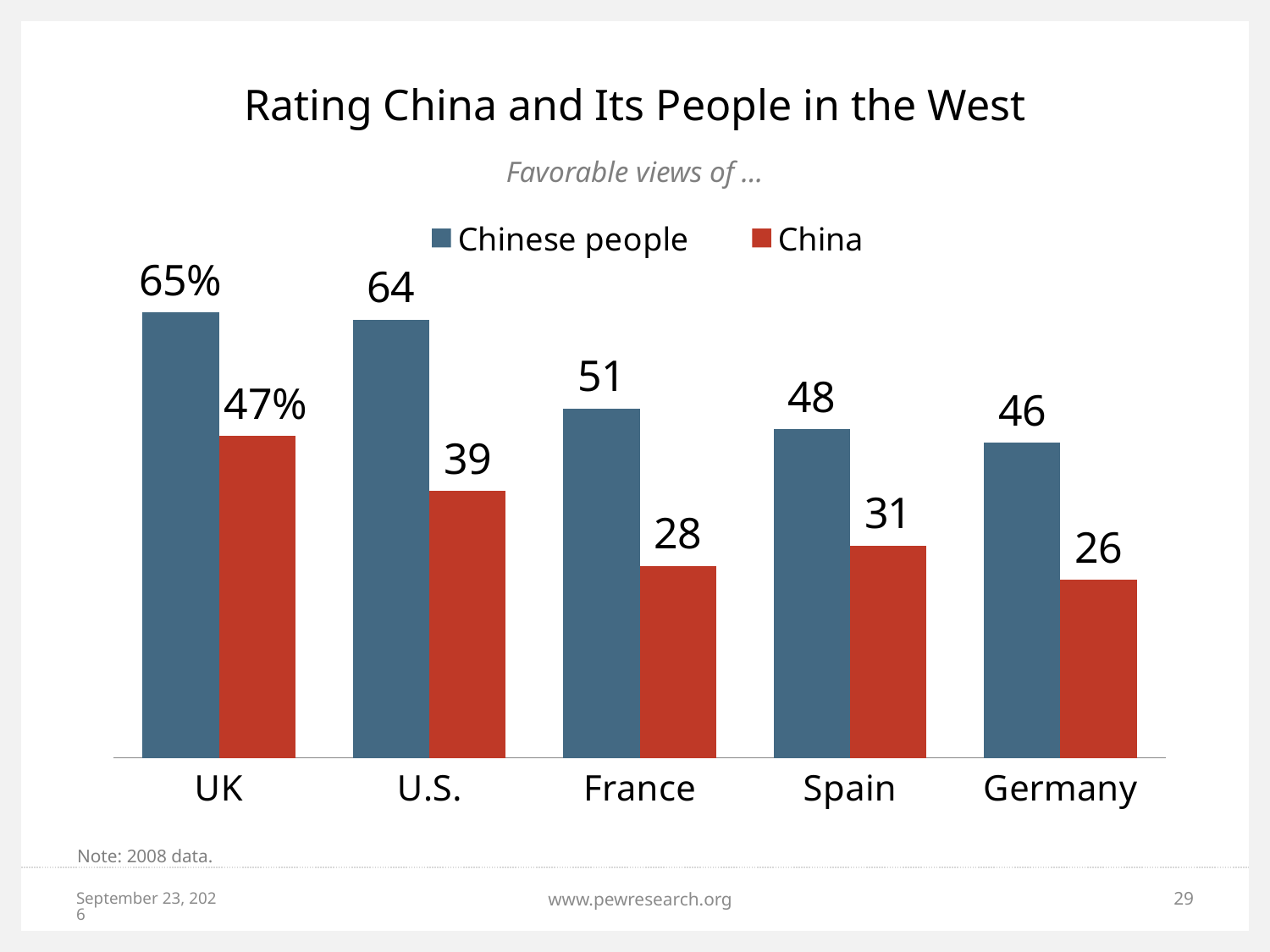
How many series does the legend list? 2 What is the value for China in Germany? 26 Which country has the highest value for Chinese people? UK Which is larger: the China value for Spain or the China value for France? Spain What is the title of the chart? Rating China and Its People in the West What is the difference between the Chinese people and China values for France? 23 What kind of chart is shown on the slide? Bar chart Which country has the lowest value for China? Germany Do the values for Chinese people rise or fall from UK to Germany along the x axis? Fall What is the value for China in the U.S.? 39 How many countries are shown on the x axis? 5 What is the value for Chinese people in the UK? 65%